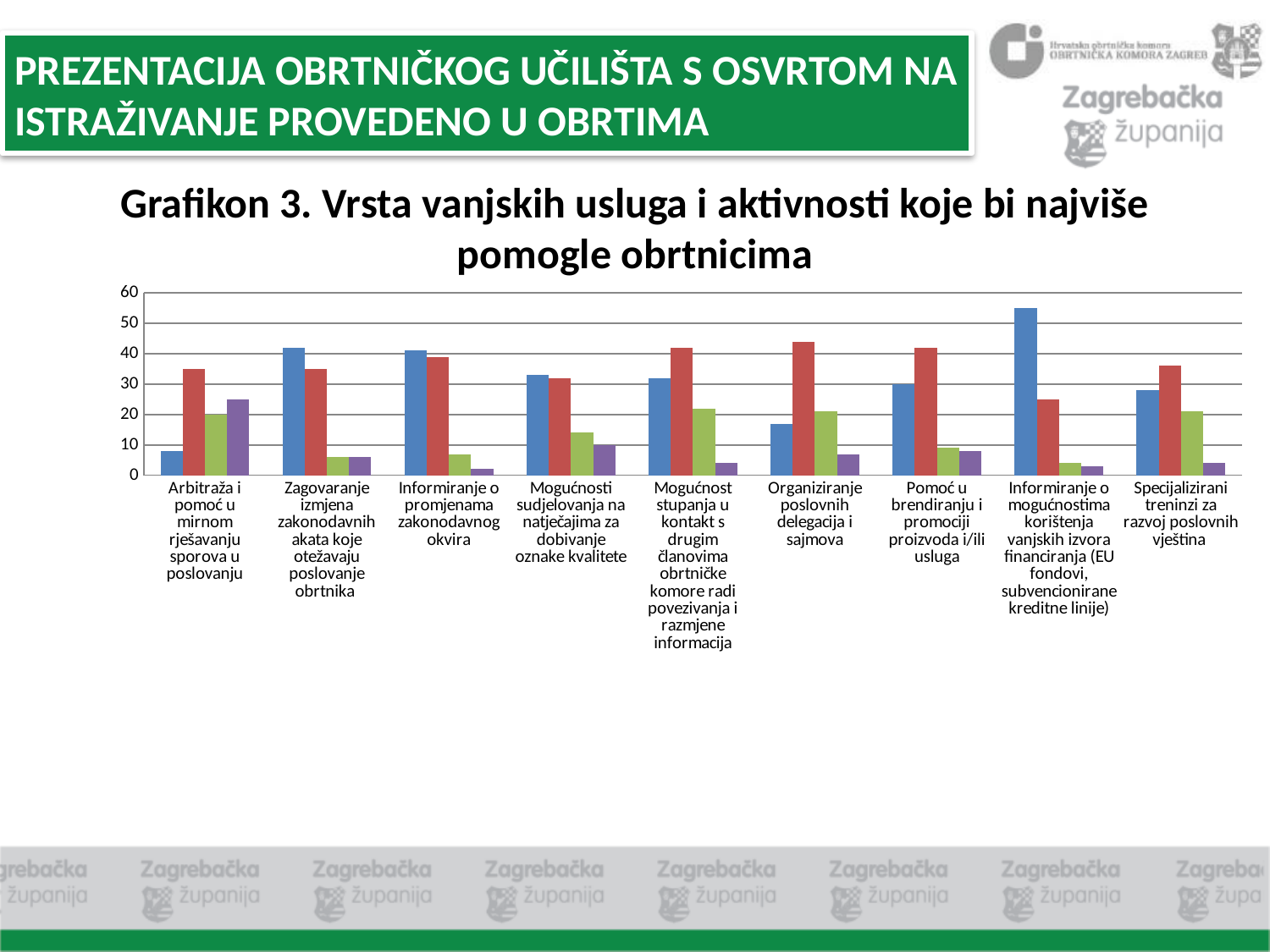
Which is larger for 'Organiziranje poslovnih delegacija i sajmova': the blue bar or the red bar? the red bar Is the green bar for 'Mogućnost stupanja u kontakt s drugim članovima obrtničke komore radi povezivanja i razmjene informacija' greater or less than 20? greater Is the red bar for 'Organiziranje poslovnih delegacija i sajmova' greater or less than 40? greater What is the title of the chart? Grafikon 3. Vrsta vanjskih usluga i aktivnosti koje bi najviše pomogle obrtnicima Which category has the tallest blue bar? Informiranje o mogućnostima korištenja vanjskih izvora financiranja (EU fondovi, subvencionirane kreditne linije) Which is larger for 'Informiranje o mogućnostima korištenja vanjskih izvora financiranja': the blue bar or the red bar? the blue bar Is the purple bar for 'Informiranje o promjenama zakonodavnog okvira' greater or less than 10? less What kind of chart is shown on the slide? bar chart How many categories are shown along the x axis of the chart? 9